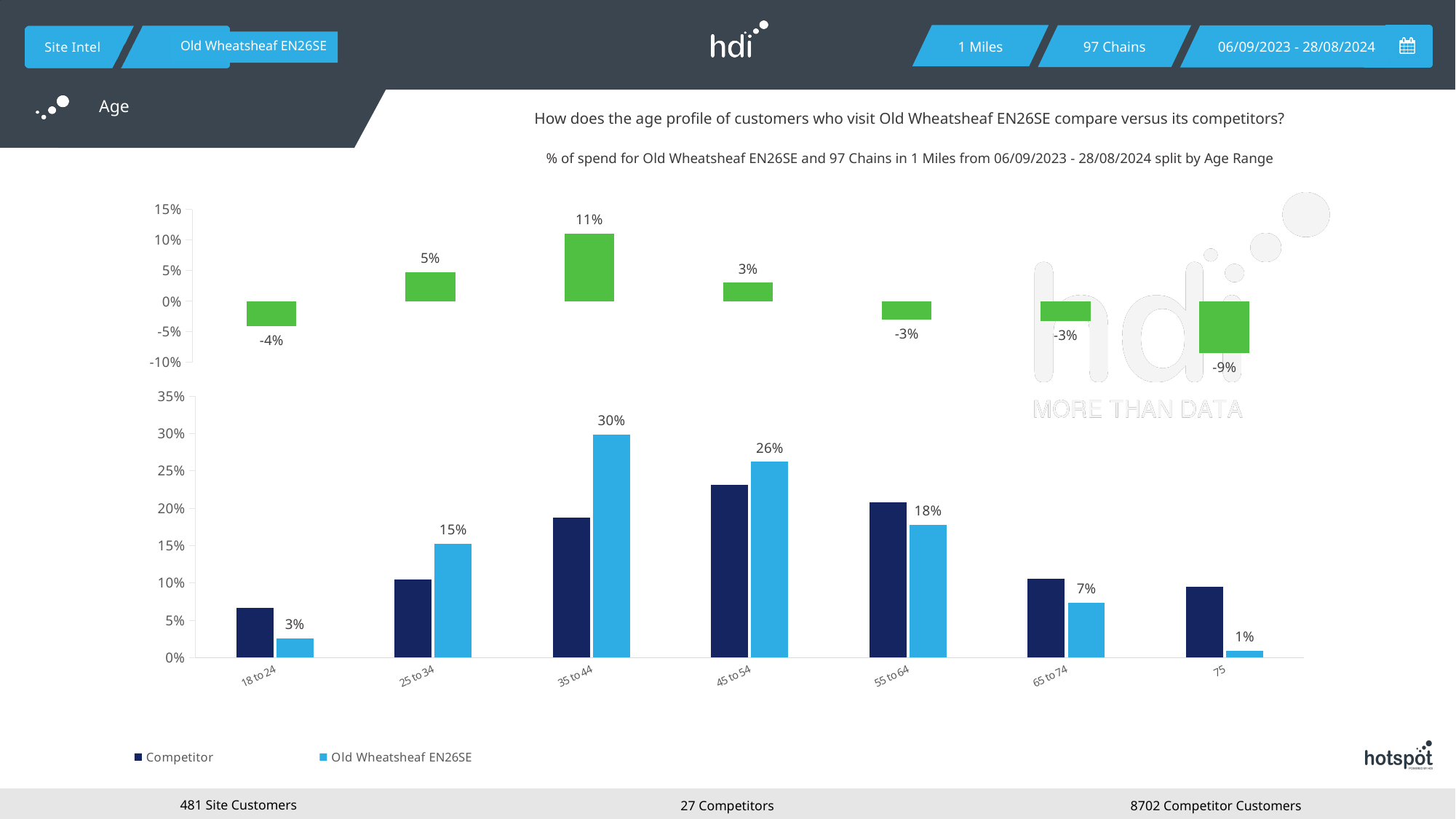
In the bottom chart, which age range has the highest value for Old Wheatsheaf EN26SE? 35 to 44 In the bottom chart, what is the value for Old Wheatsheaf EN26SE in the 18 to 24 age range? 3% In the bottom chart, is the Competitor value for 45 to 54 greater or less than 20%? greater In the bottom chart, is the Competitor value for 18 to 24 greater or less than 10%? less In the bottom chart, which is larger for the 55 to 64 age range: Competitor or Old Wheatsheaf EN26SE? Competitor In the top chart, which age range has the lowest value? 75 In the bottom chart, what is the value for Old Wheatsheaf EN26SE in the 35 to 44 age range? 30% In the bottom chart, what is the difference between the Old Wheatsheaf EN26SE values for 35 to 44 and 45 to 54? 4% How many age range categories are shown on the x axis of the bottom chart? 7 How many series does the legend of the bottom chart list? 2 In the top chart, what is the value for the 35 to 44 age range? 11% In the bottom chart, which age range has the lowest value for Old Wheatsheaf EN26SE? 75